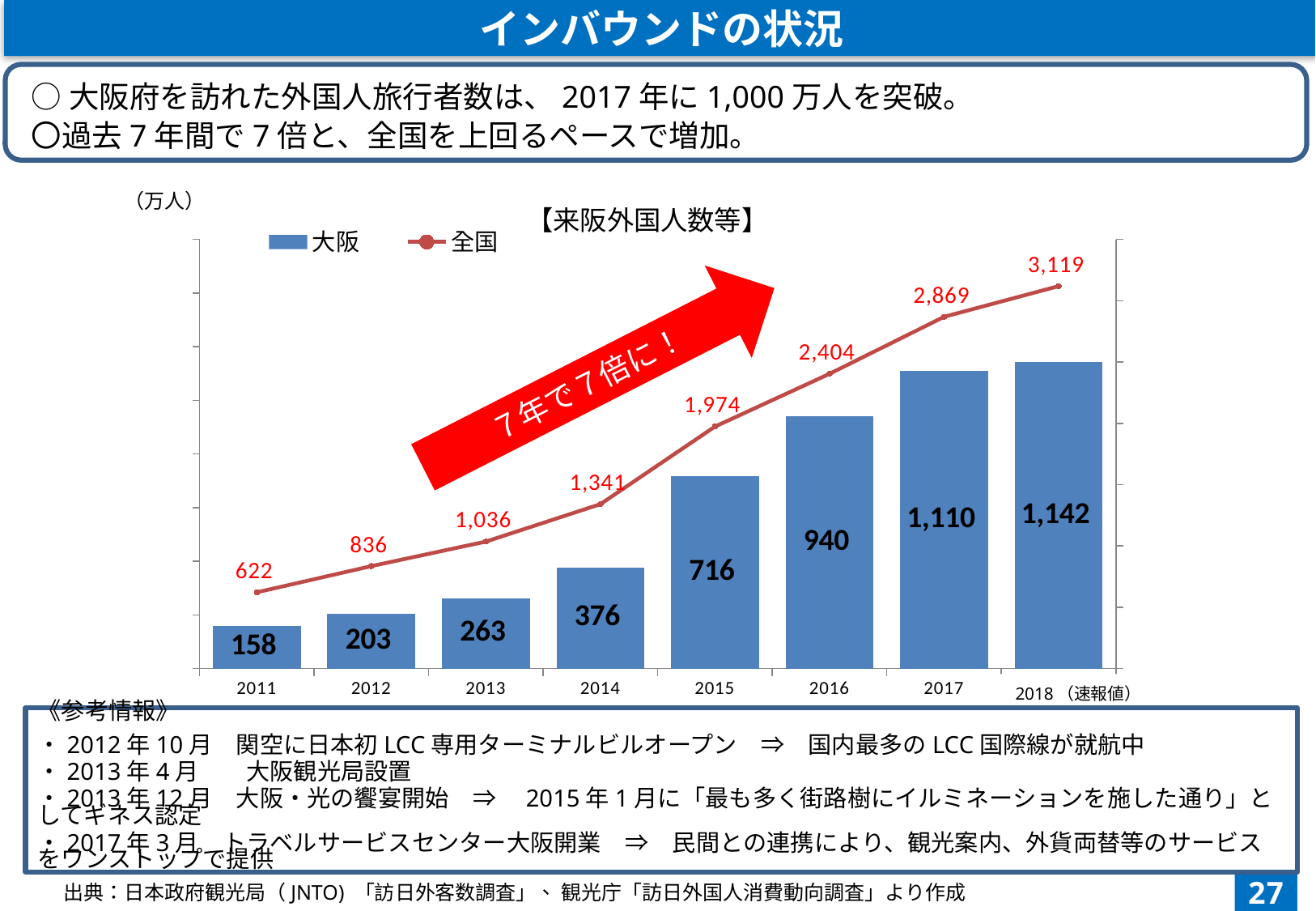
Do the 大阪 values rise or fall from 2011 to 2018? rise What is the difference between the 大阪 values for 2017 and 2016? 170 Which year has the lowest 大阪 value? 2011 How many years are shown on the x axis? 8 Which year has the highest 全国 value? 2018 What is the difference between the 全国 values for 2018 and 2011? 2,497 What is the 大阪 value for 2018 (速報値)? 1,142 How many series does the legend list? 2 What is the 全国 value for 2017? 2,869 Which is larger, the 大阪 value for 2014 or the 大阪 value for 2013? 2014 What is the value of the 大阪 bar for 2015? 716 What is the title of the chart? 【来阪外国人数等】